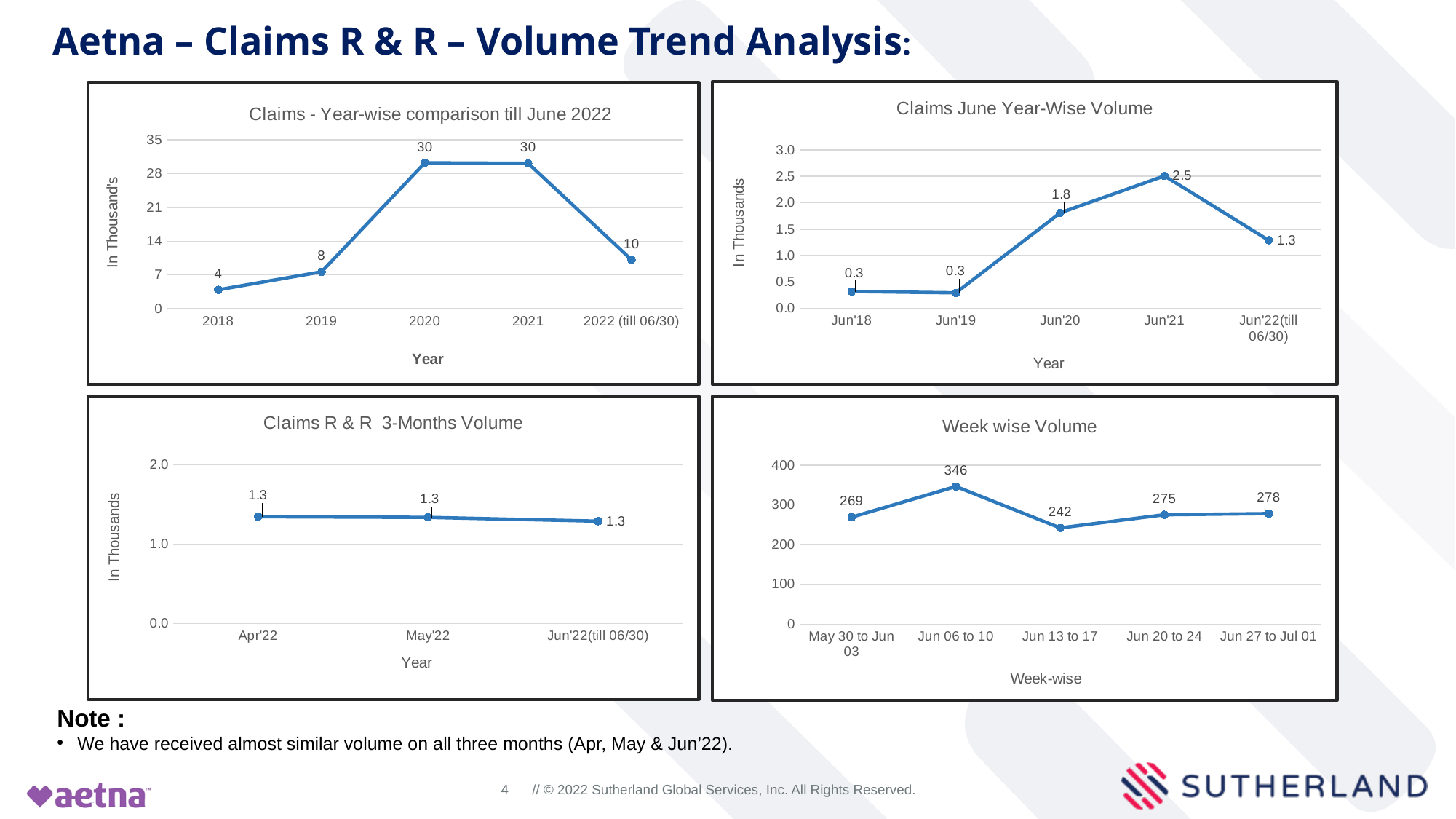
In the 'Claims June Year-Wise Volume' chart, how many data points are plotted? 5 In the 'Week wise Volume' chart, what is the difference between the values for Jun 06 to 10 and May 30 to Jun 03? 77 In the 'Week wise Volume' chart, what is the value for Jun 06 to 10? 346 In the 'Claims - Year-wise comparison till June 2022' chart, what is the difference between the values for 2021 and 2018? 26 In the 'Claims - Year-wise comparison till June 2022' chart, what is the value for 2019? 8 In the 'Claims June Year-Wise Volume' chart, which year has the highest value? Jun'21 In the 'Week wise Volume' chart, is the value for Jun 20 to 24 larger or smaller than the value for Jun 27 to Jul 01? Smaller What kind of chart is the 'Claims R & R 3-Months Volume' chart? Line chart In the 'Claims R & R 3-Months Volume' chart, what is the value for May'22? 1.3 In the 'Claims - Year-wise comparison till June 2022' chart, what is the value for 2022 (till 06/30)? 10 In the 'Week wise Volume' chart, which week has the lowest value? Jun 13 to 17 In the 'Claims June Year-Wise Volume' chart, what is the value for Jun'20? 1.8